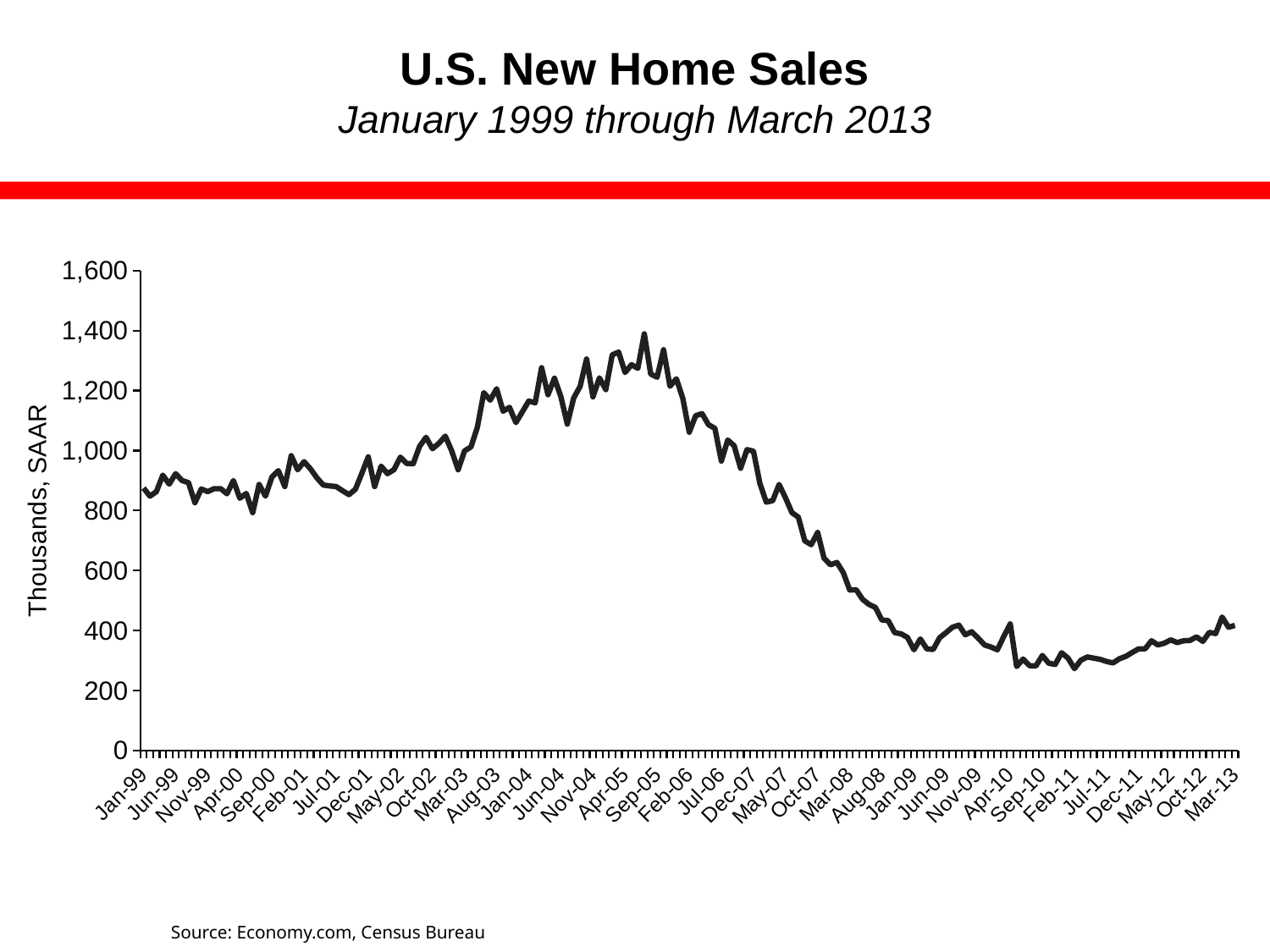
In which year does the line reach its highest point? 2005 What kind of chart is shown on the slide? line chart Is the value for Aug-08 greater or less than 600? less Which is larger, the value for Jan-99 or the value for Mar-13? Jan-99 Is the value for Jan-99 greater or less than 800? greater Is the value for Apr-05 greater or less than 1,000? greater Do new home sales rise or fall between Sep-05 and Jan-09? fall What is the title of the chart? U.S. New Home Sales What is the label on the vertical axis? Thousands, SAAR